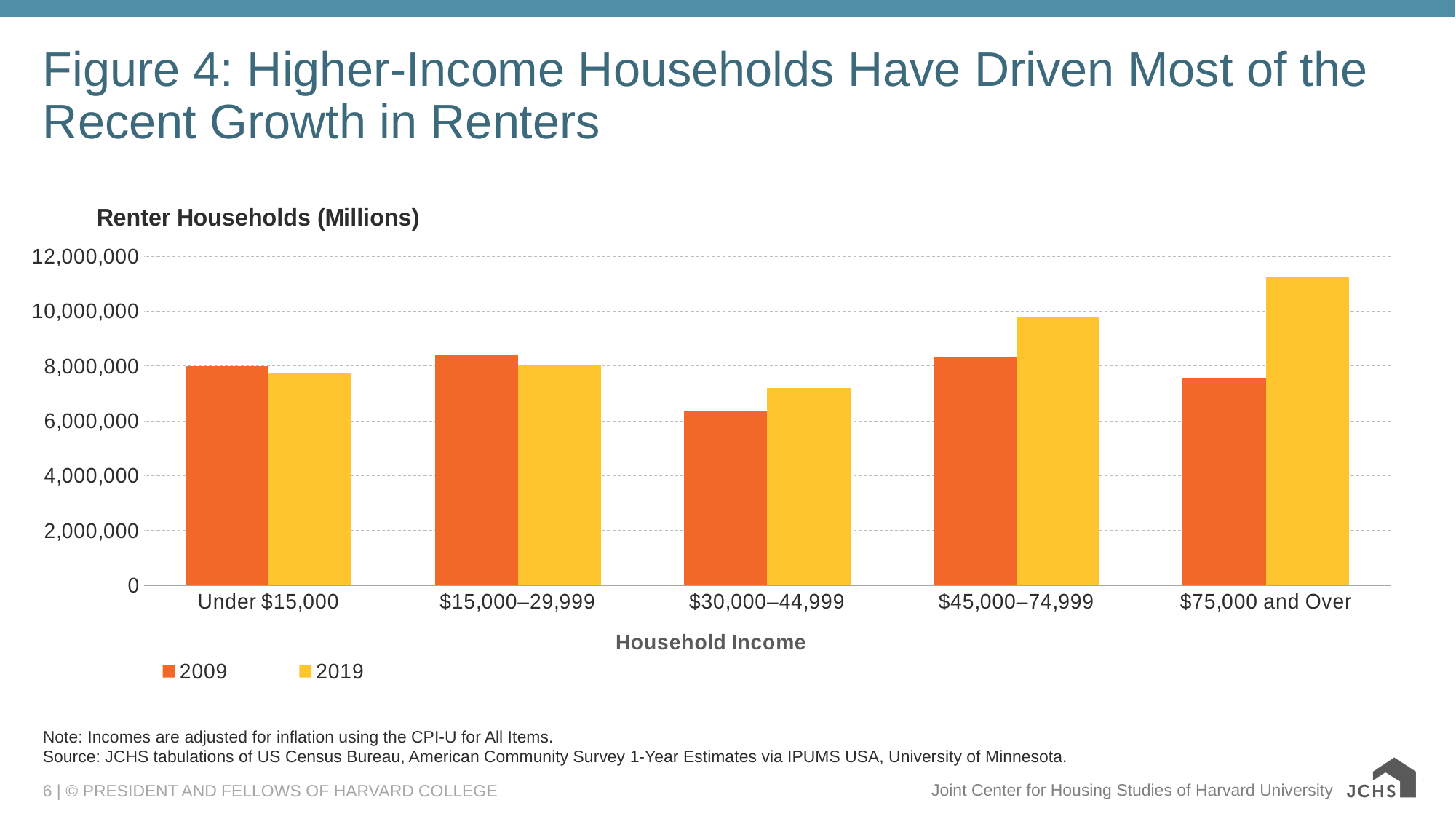
Which household income category has the lowest value for 2019? $30,000–44,999 Is the 2009 value for $30,000–44,999 greater or less than 8,000,000? less Is the 2019 value for $45,000–74,999 greater or less than 8,000,000? greater Which household income category has the highest value for 2019? $75,000 and Over How many household income categories are shown on the x axis? 5 For the $75,000 and Over category, which year has the larger value, 2009 or 2019? 2019 How many series does the legend list? 2 What type of chart is shown on the slide? Bar chart Is the 2019 value for $75,000 and Over greater or less than 10,000,000? greater For the $15,000–29,999 category, which year has the larger value, 2009 or 2019? 2009 Which household income category has the lowest value for 2009? $30,000–44,999 What is the title of the x axis? Household Income